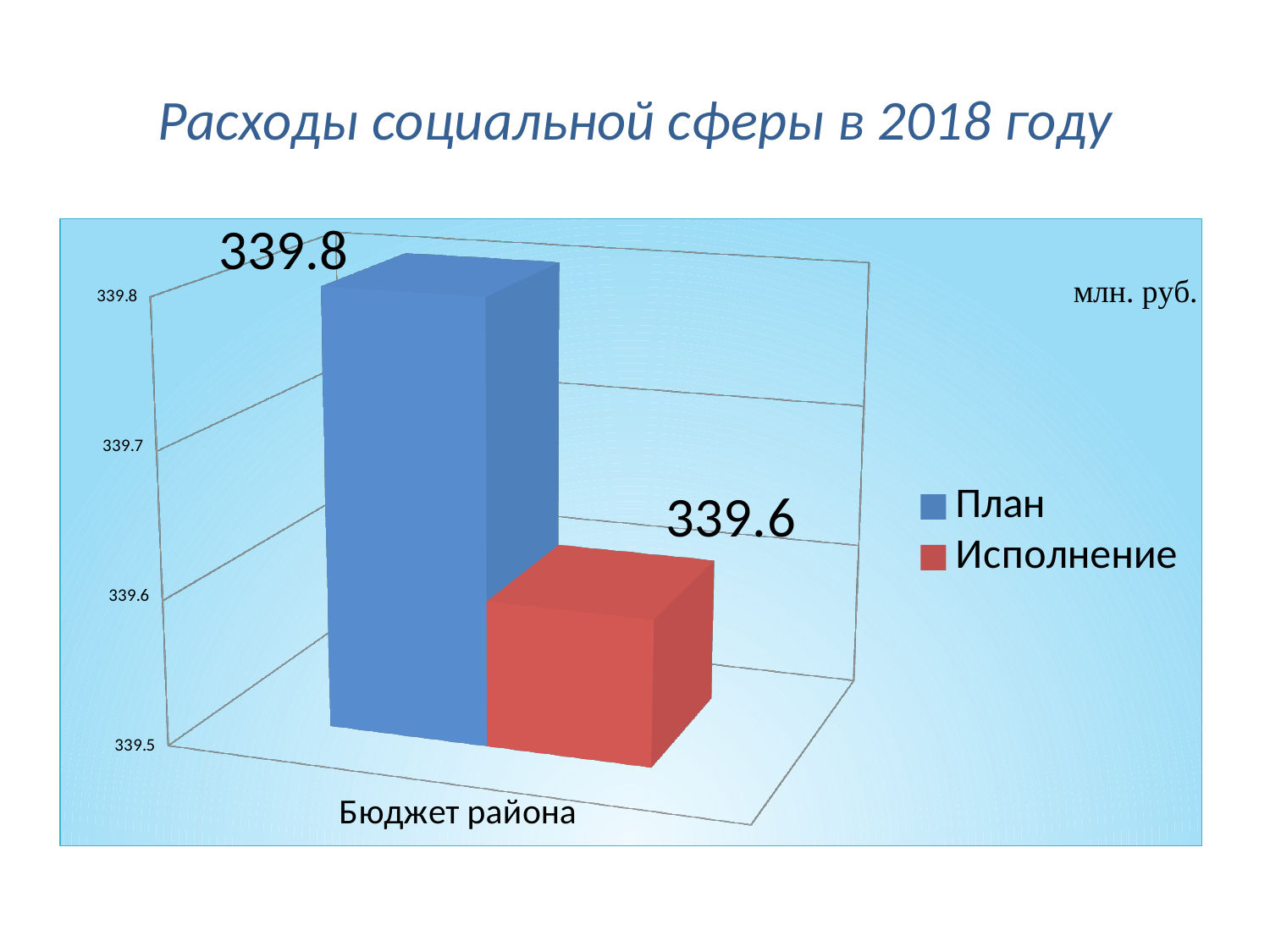
What is the value for План (Plan) for Бюджет района? 339.8 What is the value for Исполнение (Execution) for Бюджет района? 339.6 How many series does the legend list? 2 What is the difference between the План value and the Исполнение value? 0.2 Which series has the lowest value on the chart? Исполнение What kind of chart is shown on the slide? Bar chart What unit is indicated on the chart? млн. руб. Is the value for Исполнение greater or less than 339.7? less Which series has the higher value, План or Исполнение? План What is the title of the chart on the slide? Расходы социальной сферы в 2018 году How many categories are shown on the x axis? 1